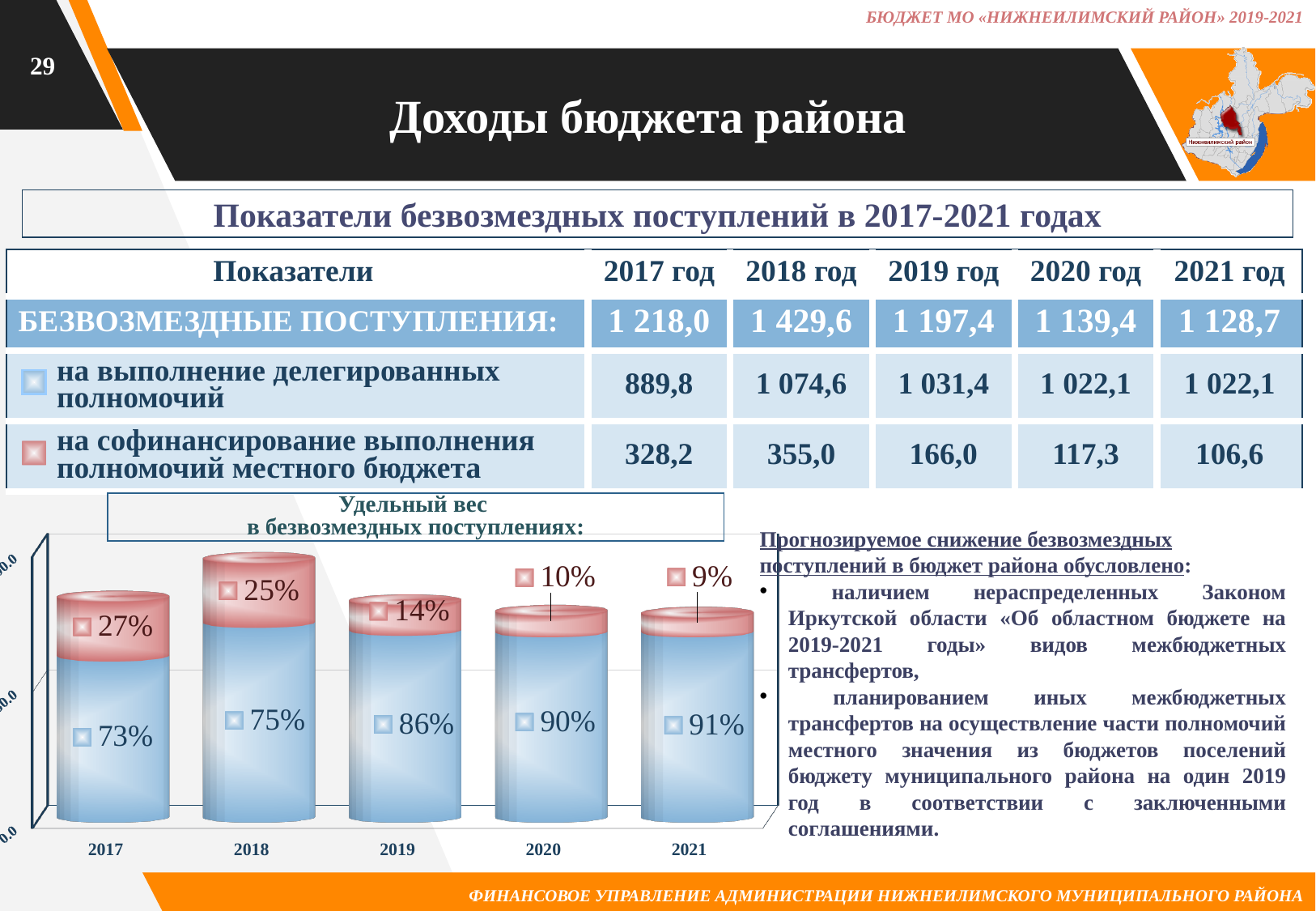
Does the blue (delegated powers) share rise or fall from 2017 to 2021? rise What is the blue (delegated powers) share for 2017 in the chart? 73% What is the red share for 2021 in the chart? 9% What is the difference between the blue share in 2021 and the blue share in 2017? 18% In which year is the red (co-financing) share the lowest? 2021 What type of chart is shown on the slide? stacked bar chart How many years (categories) are shown on the x axis of the chart? 5 In which year is the blue (delegated powers) share the highest? 2021 What is the title of the chart? Удельный вес в безвозмездных поступлениях: What is the red (co-financing) share for 2018 in the chart? 25% What is the blue share for 2019 in the chart? 86% Which is larger: the red share in 2019 or the red share in 2020? 2019